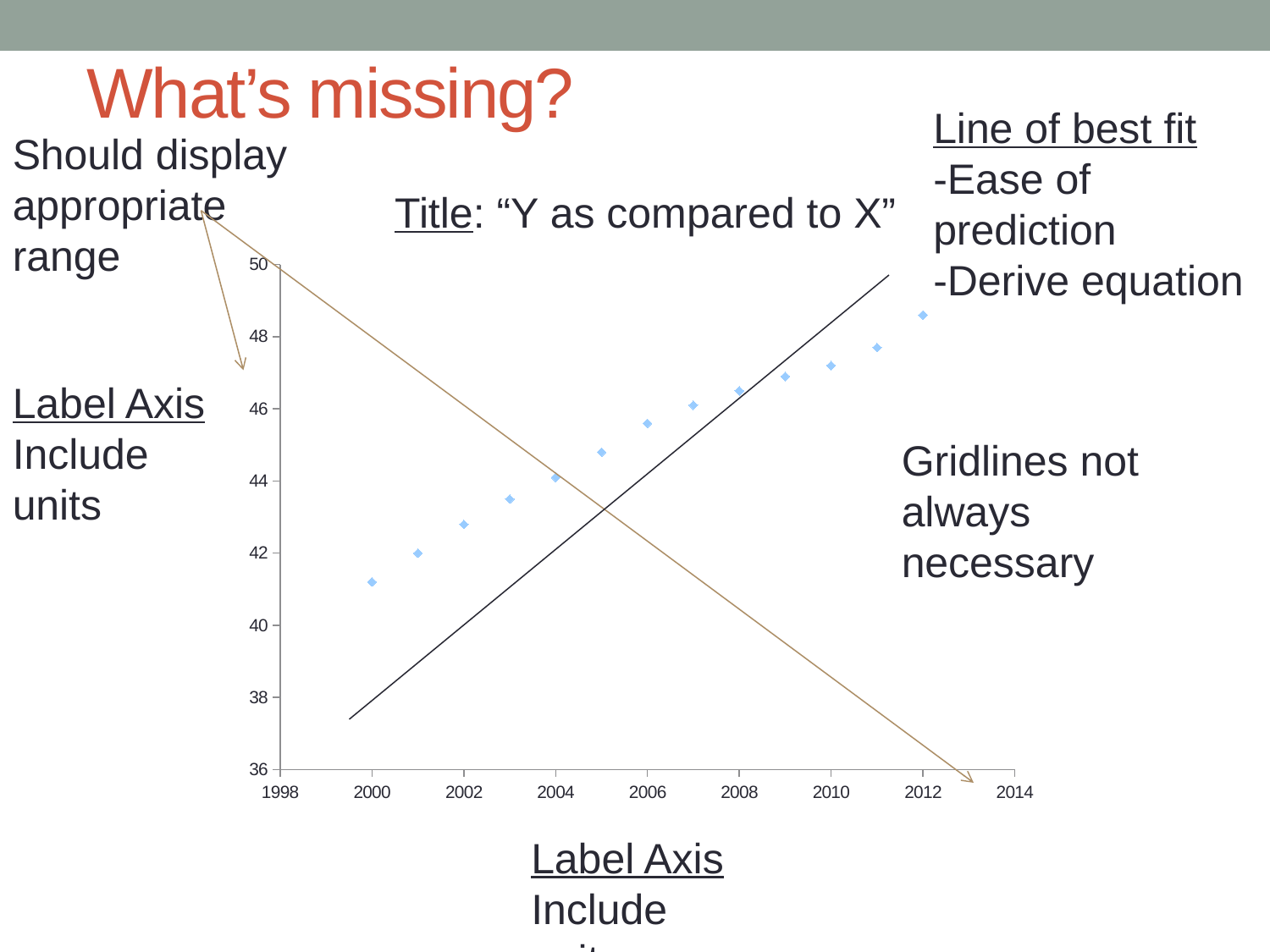
Is the value for 2006 greater or less than 44? greater Is the value for 2002 greater or less than 44? less Do the plotted values rise or fall as the year increases along the x axis? rise What is the lowest value shown on the chart's y axis? 36 Which year has the lowest plotted value? 2000 What kind of chart is shown on the slide? scatter chart Is the value for 2008 greater or less than 46? greater How many data points are plotted on the chart? 13 Which year has the highest plotted value? 2012 Which is larger, the value for 2010 or the value for 2004? 2010